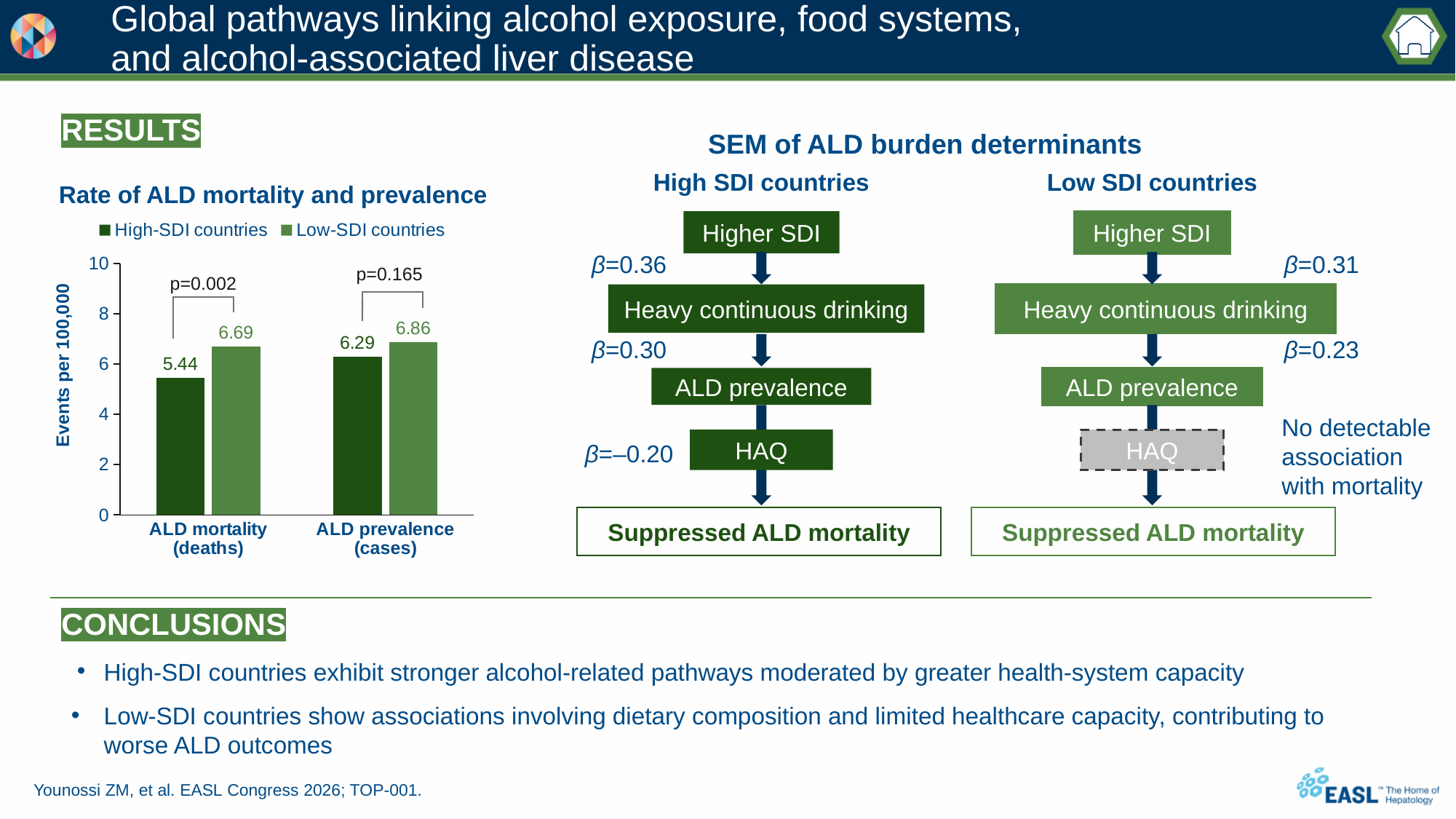
In the 'Rate of ALD mortality and prevalence' chart, what is the value for High-SDI countries for ALD mortality (deaths)? 5.44 In the 'Rate of ALD mortality and prevalence' chart, which bar is the highest? Low-SDI countries, ALD prevalence (cases) In the 'Rate of ALD mortality and prevalence' chart, what is the p-value shown for the ALD mortality (deaths) comparison? p=0.002 In the 'Rate of ALD mortality and prevalence' chart, what is the value for Low-SDI countries for ALD prevalence (cases)? 6.86 How many series does the legend of the 'Rate of ALD mortality and prevalence' chart list? 2 In the 'Rate of ALD mortality and prevalence' chart, is the value for High-SDI countries for ALD mortality (deaths) greater or less than 6? less In the 'Rate of ALD mortality and prevalence' chart, what is the value for High-SDI countries for ALD prevalence (cases)? 6.29 In the 'Rate of ALD mortality and prevalence' chart, what is the difference between Low-SDI and High-SDI countries for ALD mortality (deaths)? 1.25 In the 'Rate of ALD mortality and prevalence' chart, what is the value for Low-SDI countries for ALD mortality (deaths)? 6.69 In the 'Rate of ALD mortality and prevalence' chart, which is larger for ALD prevalence (cases): High-SDI countries or Low-SDI countries? Low-SDI countries In the 'Rate of ALD mortality and prevalence' chart, which bar is the lowest? High-SDI countries, ALD mortality (deaths) What kind of chart is 'Rate of ALD mortality and prevalence'? Bar chart